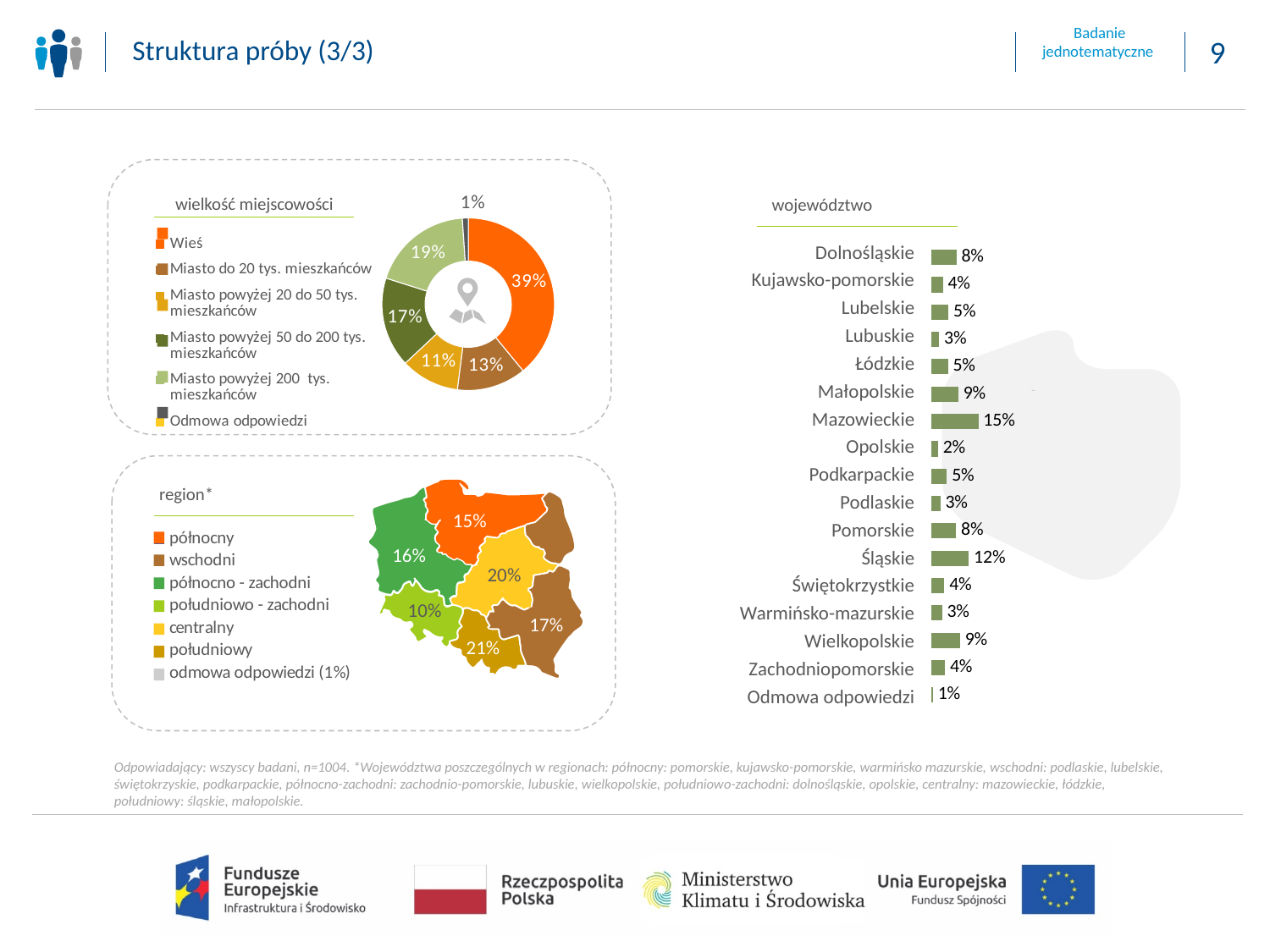
In the 'województwo' bar chart, what is the difference between the values for Śląskie and Dolnośląskie? 4% In the 'wielkość miejscowości' chart, which category has the smallest share? Odmowa odpowiedzi In the 'województwo' bar chart, which voivodeship has the highest value? Mazowieckie What kind of chart is the 'województwo' chart? bar chart In the 'województwo' bar chart, which voivodeship has the lowest value (excluding 'Odmowa odpowiedzi')? Opolskie In the 'województwo' bar chart, what is the value for Mazowieckie? 15% In the 'województwo' bar chart, which is larger: the value for Wielkopolskie or the value for Pomorskie? Wielkopolskie In the 'wielkość miejscowości' chart, what share does 'Wieś' have? 39% How many entries does the legend of the 'wielkość miejscowości' chart list? 6 In the 'region*' map, what is the value for the 'południowy' region? 21% In the 'wielkość miejscowości' chart, what is the value for 'Miasto powyżej 200 tys. mieszkańców'? 19% How many categories are shown in the 'województwo' bar chart? 17